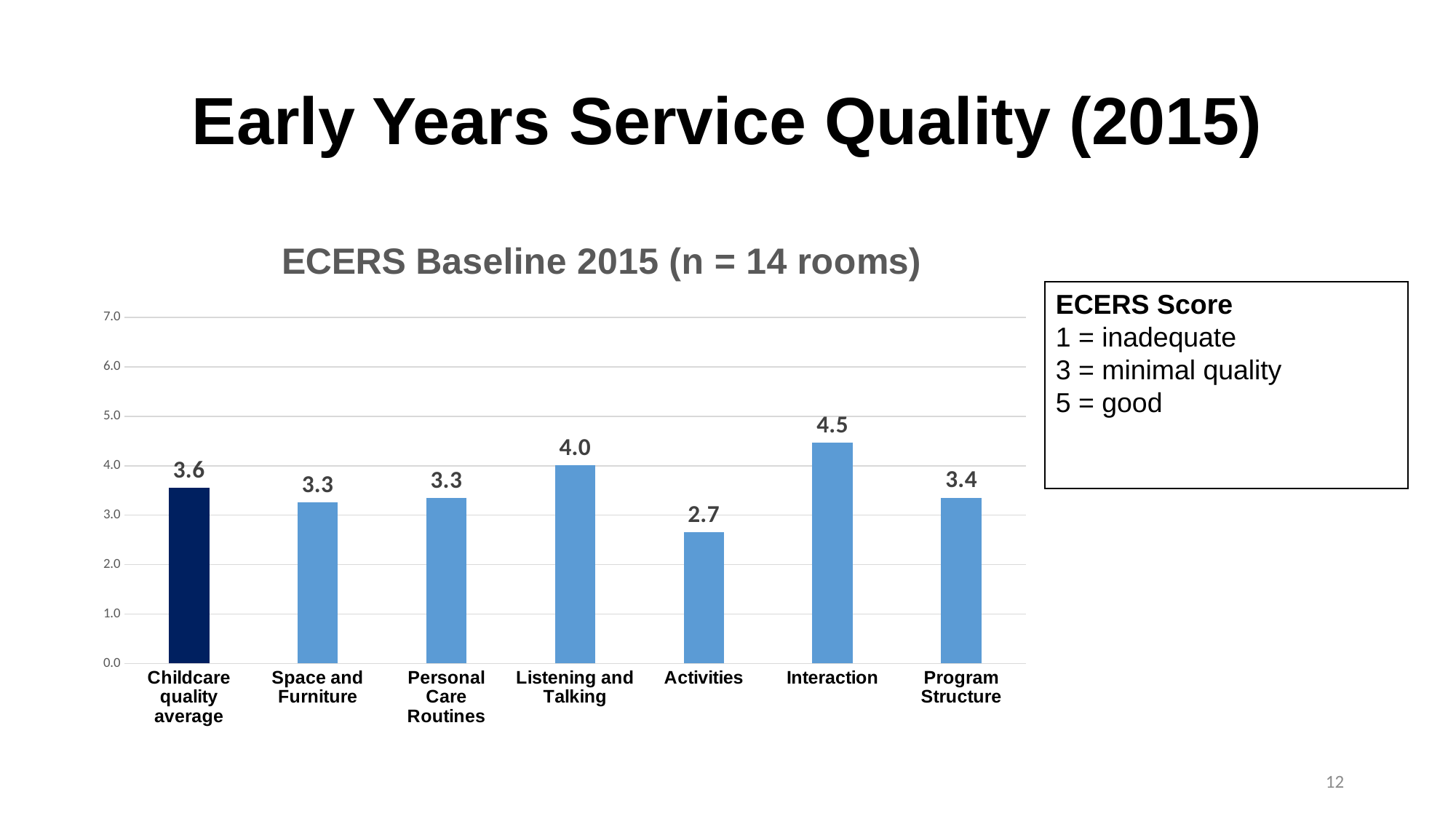
What is the value for Interaction? 4.5 What is the value for Activities? 2.7 Which is larger, the value for Listening and Talking or the value for Program Structure? Listening and Talking What kind of chart is shown on the slide? Bar chart Is the value for Interaction greater or less than 4.0? greater What is the difference between the values for Interaction and Activities? 1.8 What is the value for Program Structure? 3.4 How many categories are shown on the x axis? 7 What is the title of the chart? ECERS Baseline 2015 (n = 14 rooms) Which category has the highest value? Interaction What is the value for Childcare quality average? 3.6 Which category has the lowest value? Activities